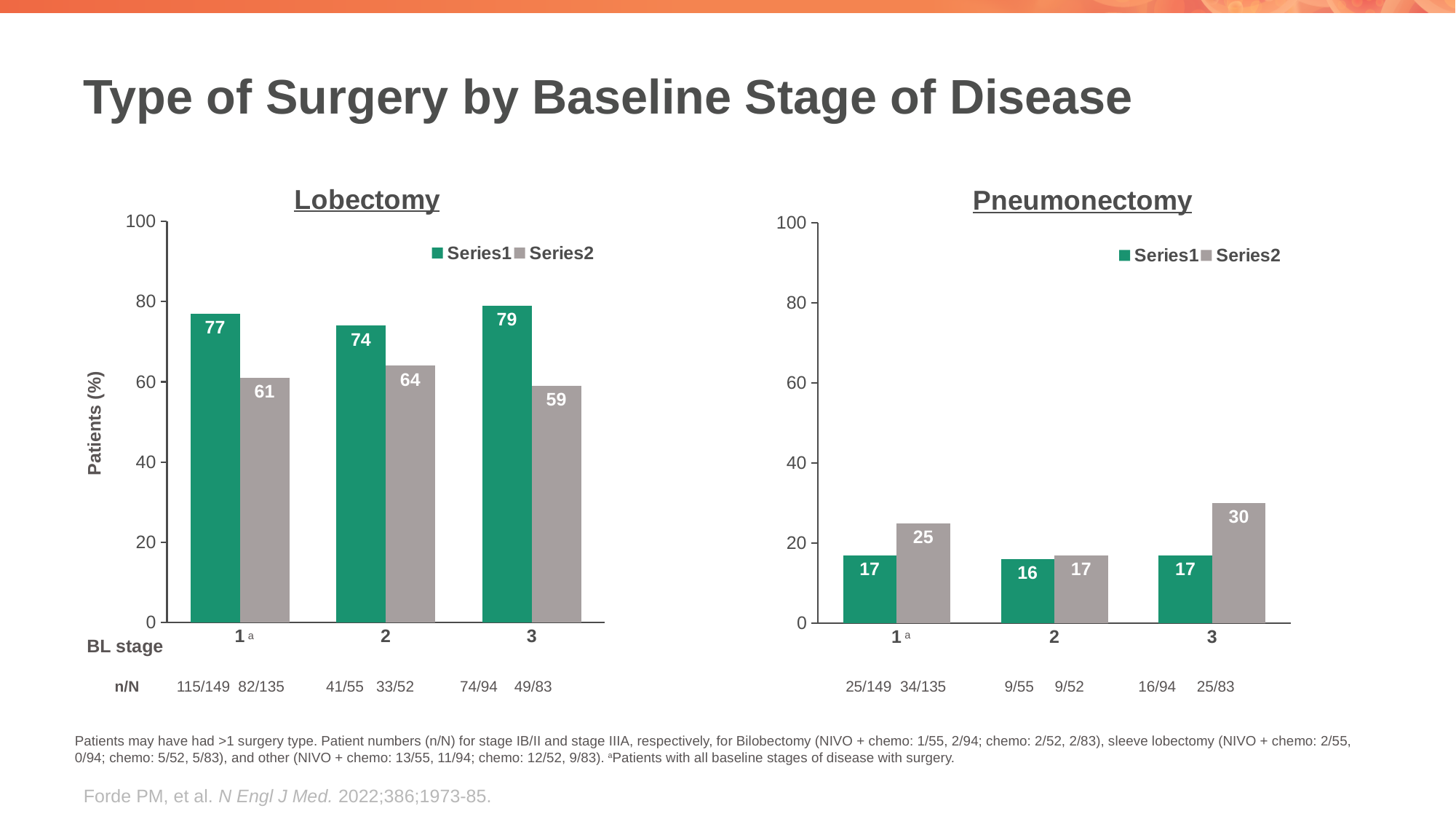
How many BL stage categories are shown in the Pneumonectomy chart? 3 In the Lobectomy chart, which BL stage has the highest Series1 value? 3 What type of chart is the Pneumonectomy chart? Bar chart How many series does the legend of the Lobectomy chart list? 2 In the Pneumonectomy chart, what is the value for Series2 at BL stage 1? 25 In the Pneumonectomy chart, which BL stage has the lowest Series2 value? 2 In the Lobectomy chart, what is the difference between Series1 and Series2 at BL stage 3? 20 In the Lobectomy chart, what is the value for Series1 at BL stage 2? 74 In the Lobectomy chart, which is larger at BL stage 1: Series1 or Series2? Series1 In the Lobectomy chart, what is the value for Series2 at BL stage 3? 59 In the Pneumonectomy chart, what is the difference between Series2 and Series1 at BL stage 3? 13 In the Pneumonectomy chart, what is the value for Series1 at BL stage 2? 16